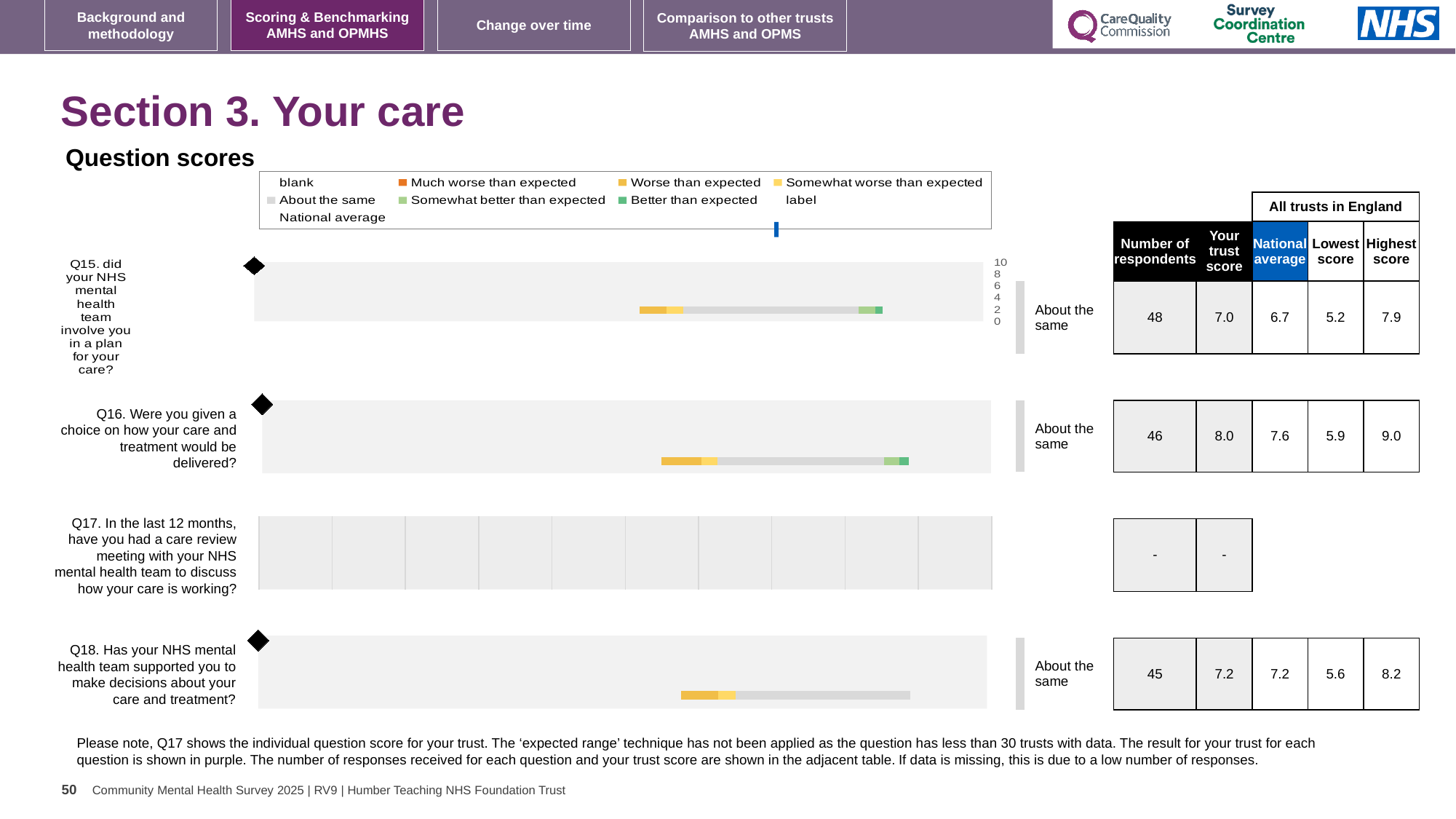
What is the highest score across all trusts in England for Q16? 9.0 Which question has the highest trust score among those with a score shown? Q16 What is the national average for Q16 (were you given a choice on how your care and treatment would be delivered)? 7.6 What comparison label is shown next to the bar for Q18? About the same What is the difference between the trust score and the national average for Q16? 0.4 Which is larger: the trust score for Q15 or the trust score for Q18? Q18 How many respondents answered Q18? 45 Which question has the lowest number of respondents among those with a value shown? Q18 What is the trust score for Q15 (did your NHS mental health team involve you in a plan for your care)? 7.0 How many questions (categories) are shown in the question scores chart? 4 What kind of chart is used to show the question scores on this slide? bar chart What is shown in the number of respondents and trust score cells for Q17? -